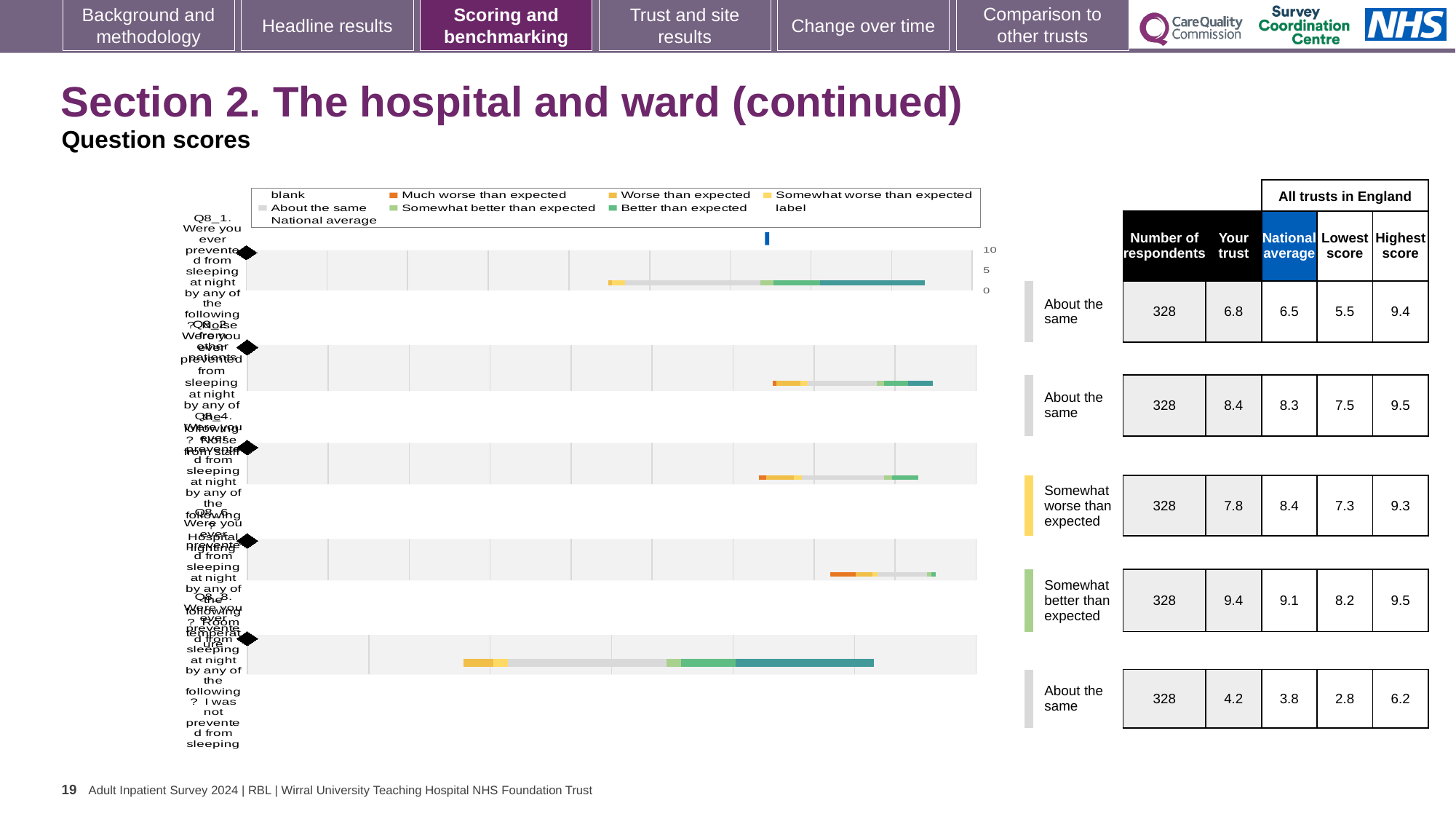
How many respondents are listed for the first row? 328 What kind of chart is shown on the slide? bar chart For the first row, what is the difference between the 'Your trust' score and the national average? 0.3 What is the national average for the row benchmarked as 'Somewhat better than expected'? 9.1 For the row benchmarked as 'Somewhat better than expected', what is the difference between the highest score and the lowest score? 1.3 Which row has the highest 'Your trust' score? The fourth row (Somewhat better than expected), 9.4 How many rows are benchmarked as 'About the same'? 3 How many question bars are plotted in the chart? 5 What is the 'Your trust' score for the row benchmarked as 'Somewhat worse than expected'? 7.8 Which row has the lowest 'Your trust' score? The fifth (bottom) row, 4.2 What is the lowest score across all trusts in England for the bottom row? 2.8 In the row benchmarked as 'Somewhat worse than expected', which is larger: the 'Your trust' score or the national average? National average